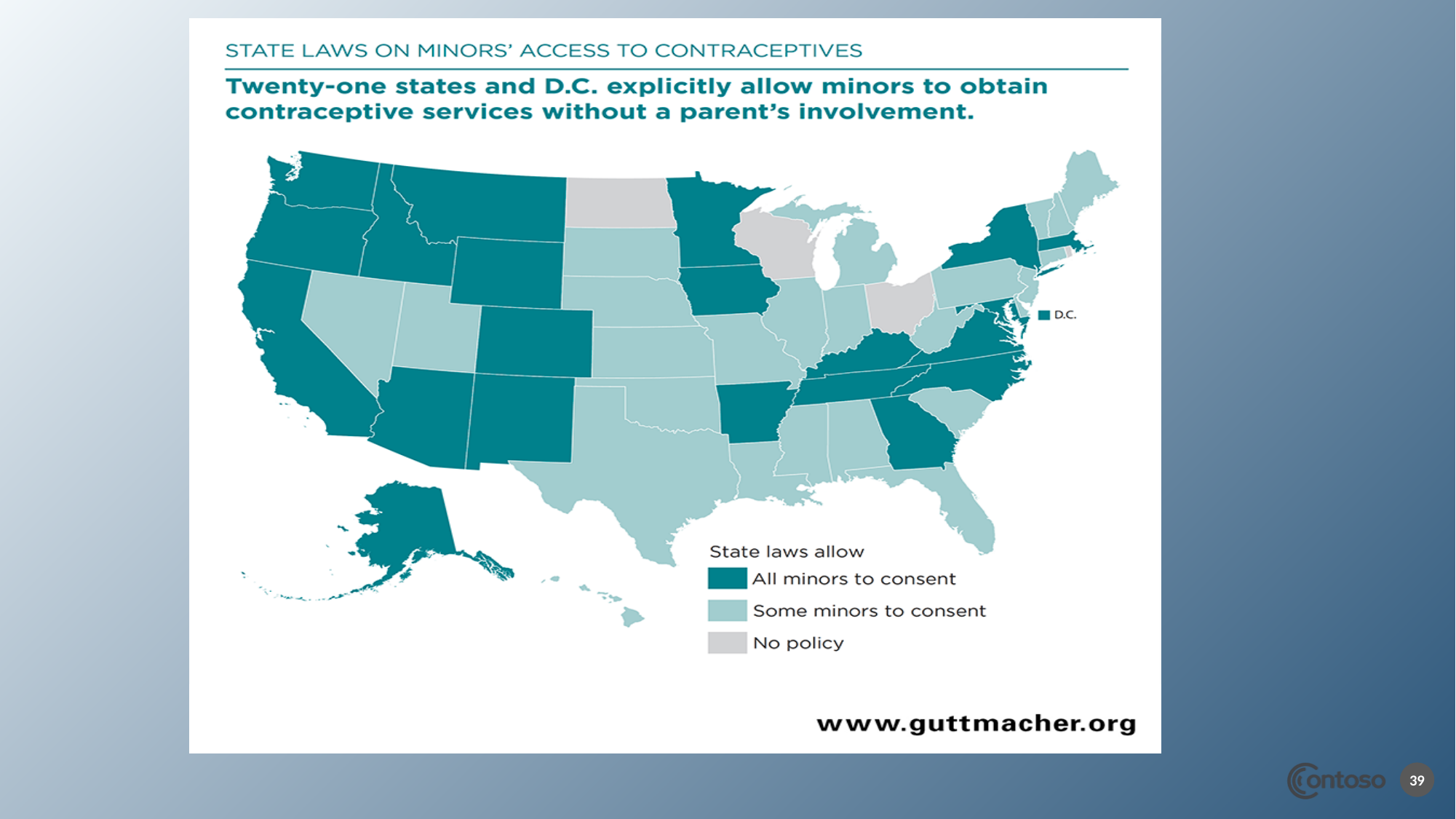
Which colour represents states with no policy on the map? Grey What are the three categories in the map legend? All minors to consent; Some minors to consent; No policy What kind of chart is shown on the slide? A map (choropleth map of U.S. states) How many categories does the map legend list? 3 What is the heading of the map legend? State laws allow Which legend category does D.C. fall into on the map? All minors to consent According to the slide's headline, how many states explicitly allow minors to obtain contraceptive services without a parent's involvement? Twenty-one states and D.C.